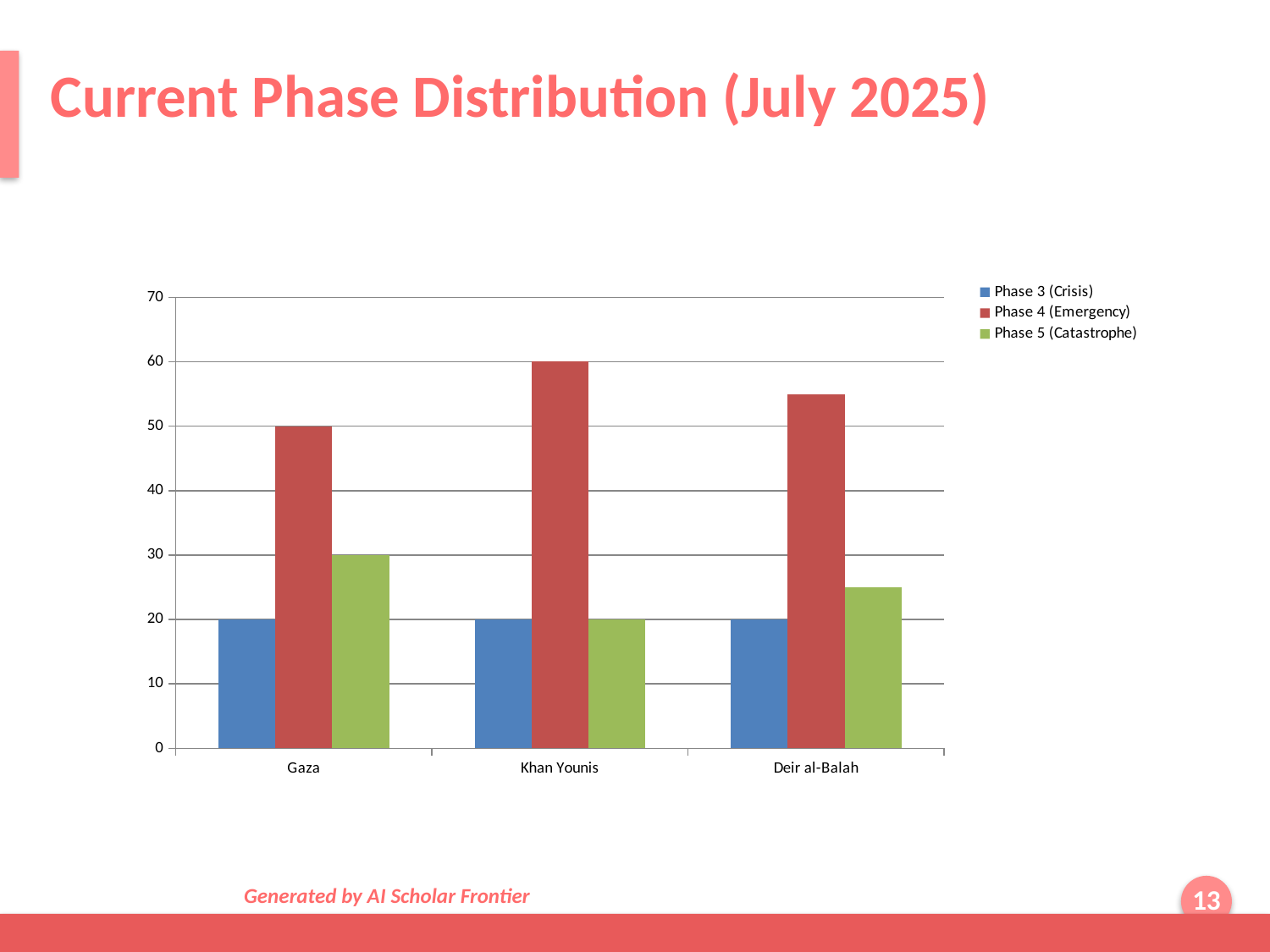
What is the value for Phase 4 (Emergency) in Gaza? 50 What is the value for Phase 5 (Catastrophe) in Gaza? 30 Which category has the lowest value for Phase 5 (Catastrophe)? Khan Younis How many series does the legend list? 3 Which category has the highest value for Phase 4 (Emergency)? Khan Younis What is the value for Phase 3 (Crisis) in Deir al-Balah? 20 What kind of chart is shown on the slide? Bar chart Which is larger in Khan Younis: Phase 4 (Emergency) or Phase 5 (Catastrophe)? Phase 4 (Emergency) Is the value for Phase 4 (Emergency) in Deir al-Balah greater or less than 50? greater Is the value for Phase 5 (Catastrophe) in Deir al-Balah greater or less than 30? less What is the value for Phase 4 (Emergency) in Khan Younis? 60 What is the difference between Phase 4 (Emergency) and Phase 3 (Crisis) in Gaza? 30